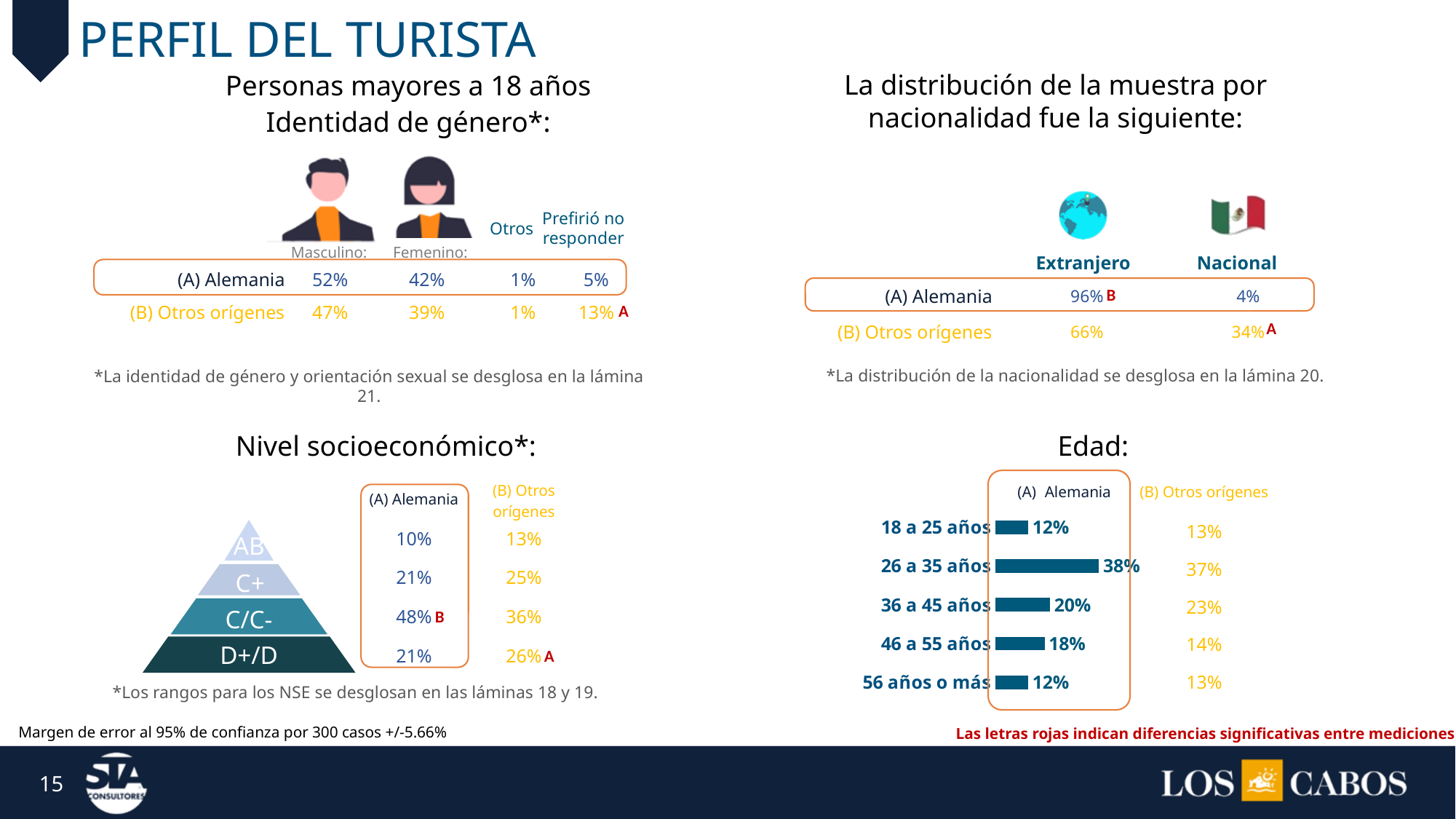
In the Edad chart, what is the difference between the (A) Alemania values for 26 a 35 años and 36 a 45 años? 18% In the Edad chart, what is the difference between (B) Otros orígenes and (A) Alemania for 36 a 45 años? 3% In the Edad chart, what is the value for 56 años o más for (A) Alemania? 12% What is the title of the bar chart in the lower right of the slide? Edad: In the Edad chart, what is the value for 46 a 55 años for (A) Alemania? 18% What kind of chart is the Edad chart? bar chart In the Edad chart, what is the value for 26 a 35 años for (A) Alemania? 38% In the Edad chart, what is the total of the (A) Alemania values across all age groups? 100% How many age groups are shown in the Edad chart? 5 In the Edad chart, which is larger for (A) Alemania: 36 a 45 años or 46 a 55 años? 36 a 45 años In the Edad chart, which age group has the highest value for (A) Alemania? 26 a 35 años In the Edad chart, what is the value for 26 a 35 años for (B) Otros orígenes? 37%